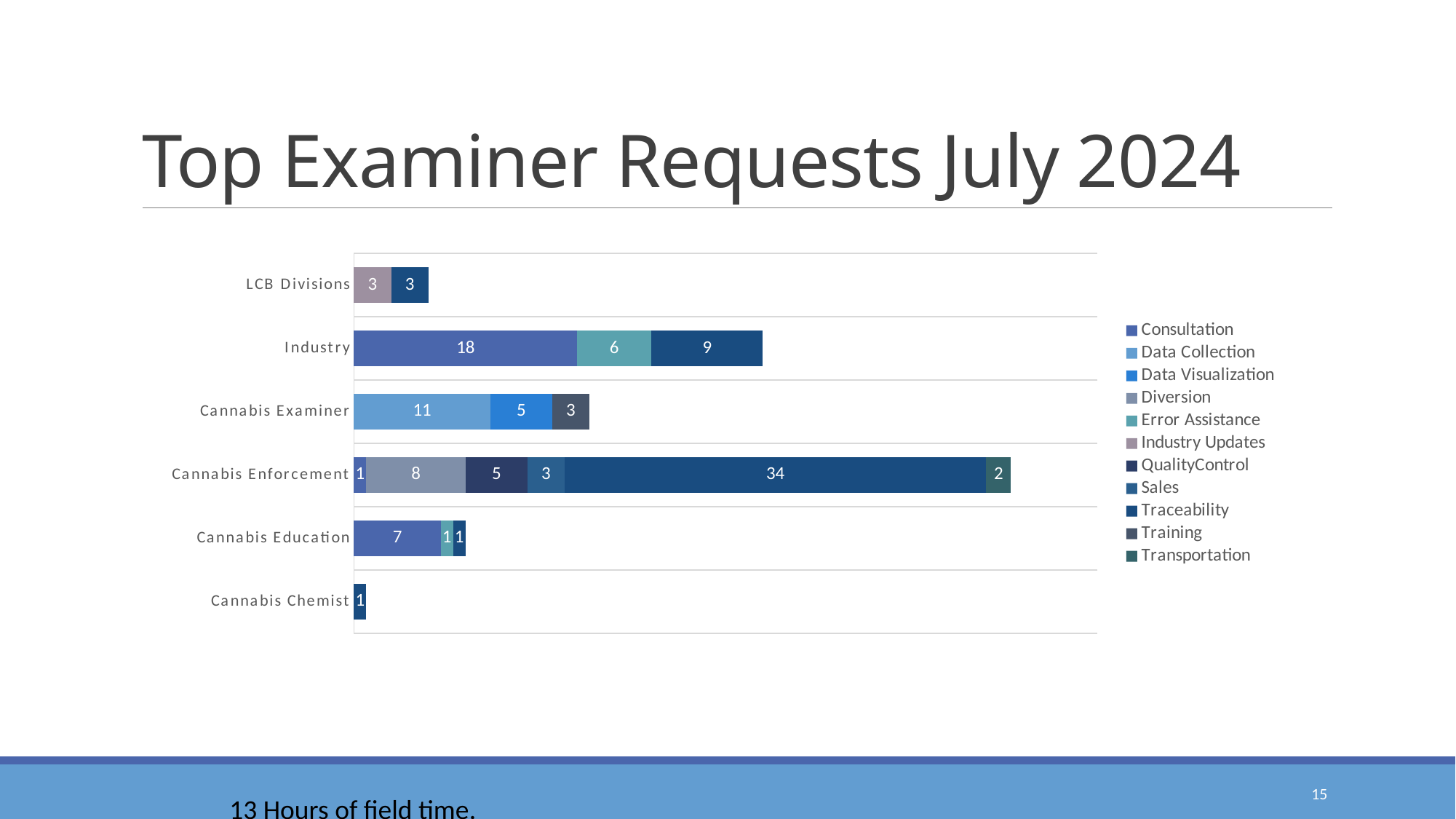
How many series does the legend list? 11 What is the total of the stacked bar for Industry? 33 What is the largest single segment value shown in the Cannabis Enforcement bar? 34 Which category has the longest stacked bar overall? Cannabis Enforcement What is the difference between the Traceability value for Cannabis Enforcement (34) and the Traceability value for Industry (9)? 25 What is the total of the stacked bar for Cannabis Examiner? 19 What is the Data Collection value for Cannabis Examiner? 11 What is the total of the stacked bar for Cannabis Enforcement? 53 What kind of chart is shown on the slide? stacked bar chart How many categories are shown on the vertical axis of the chart? 6 What is the Consultation value for Industry? 18 Which category has the shortest stacked bar overall? Cannabis Chemist